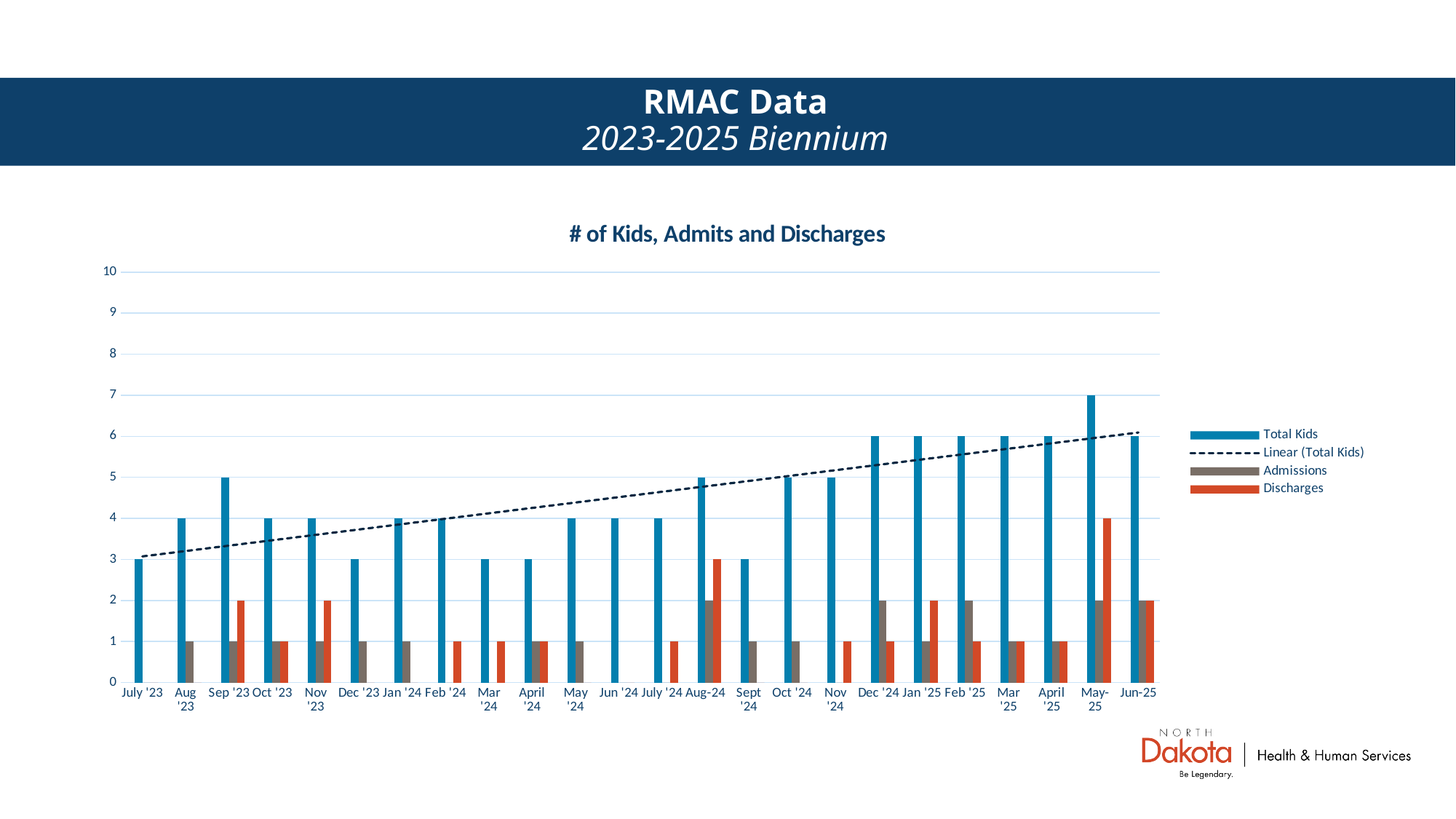
What is the Discharges value for Aug-24? 3 Which month has the highest Discharges value? May-25 Which month has the highest Total Kids value? May-25 What is the difference between the Total Kids value for May-25 and the Total Kids value for July '23? 4 Which is larger, the Total Kids value for Sep '23 or the Total Kids value for Dec '23? Sep '23 What is the Total Kids value for May-25? 7 How many entries does the legend list? 4 How many months are shown on the x axis? 24 Is the Total Kids value for Dec '24 greater or less than 5? greater What is the Admissions value for Feb '25? 2 Does the Linear (Total Kids) trend line rise or fall from left to right? rise What is the Total Kids value for July '23? 3